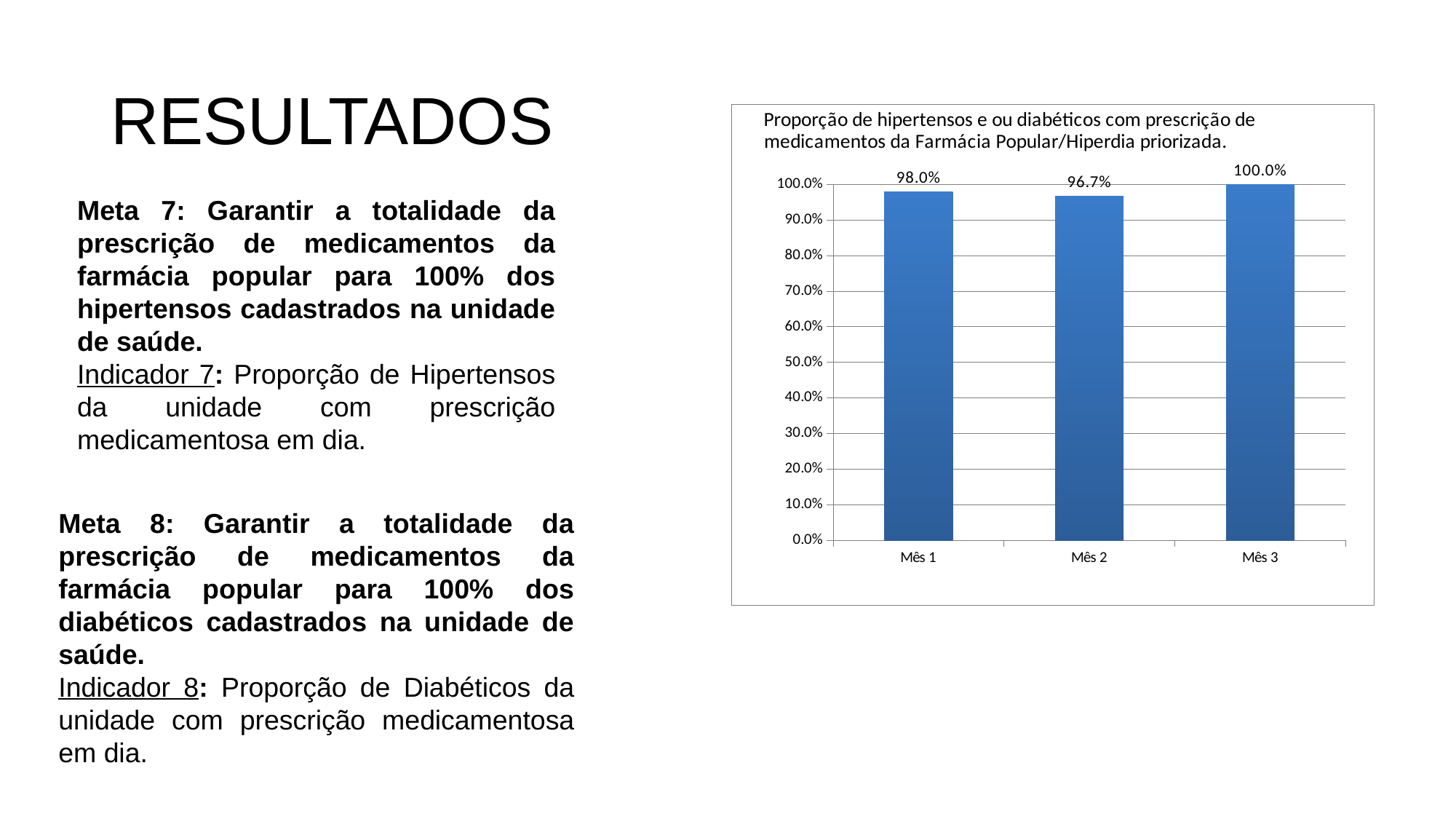
Which month has the lowest value? Mês 2 Which month has the highest value? Mês 3 What is the title of the chart? Proporção de hipertensos e ou diabéticos com prescrição de medicamentos da Farmácia Popular/Hiperdia priorizada. What is the difference between the values for Mês 1 and Mês 2? 1.3% What is the value for Mês 3? 100.0% What kind of chart is shown on the slide? Bar chart What is the difference between the values for Mês 3 and Mês 2? 3.3% What is the value for Mês 1? 98.0% How many months are shown on the x axis? 3 Is the value for Mês 2 greater or less than 90.0%? greater What is the value for Mês 2? 96.7% Which is larger, the value for Mês 1 or the value for Mês 2? Mês 1